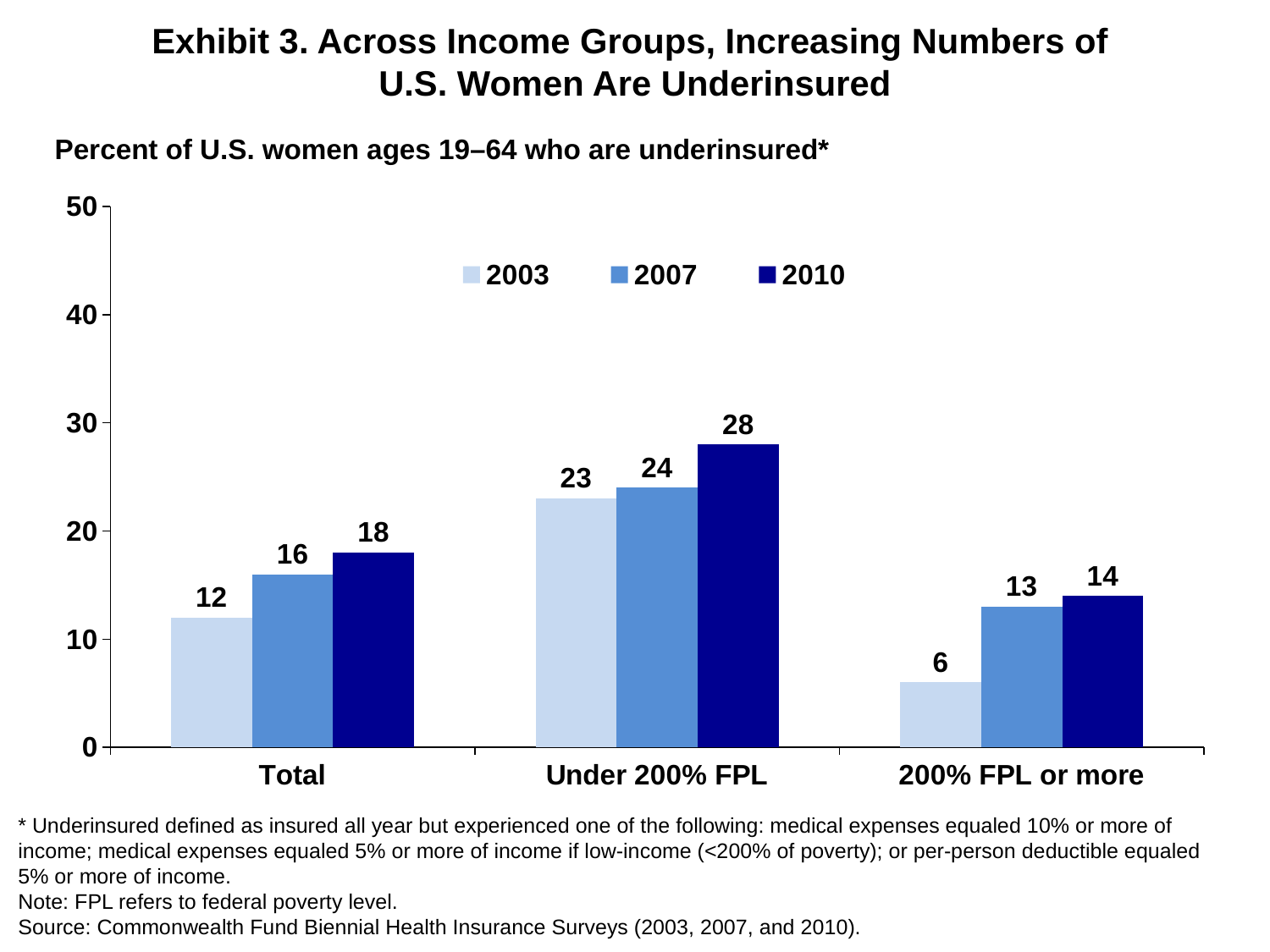
What kind of chart is shown on the slide? Bar chart What is the difference between the 2010 and 2003 values for the Total group? 6 How many income groups are shown on the x axis? 3 Which income group has the highest value for 2010? Under 200% FPL What is the value for 2010 in the Under 200% FPL group? 28 What is the value for 2007 in the Total group? 16 What is the value for 2003 in the 200% FPL or more group? 6 Do the values for the Total group rise or fall from 2003 to 2010? Rise Which income group has the lowest value for 2003? 200% FPL or more How many series does the legend list? 3 Which is larger: the 2007 value for Total or the 2007 value for 200% FPL or more? Total What is the difference between the 2010 values for Under 200% FPL and 200% FPL or more? 14